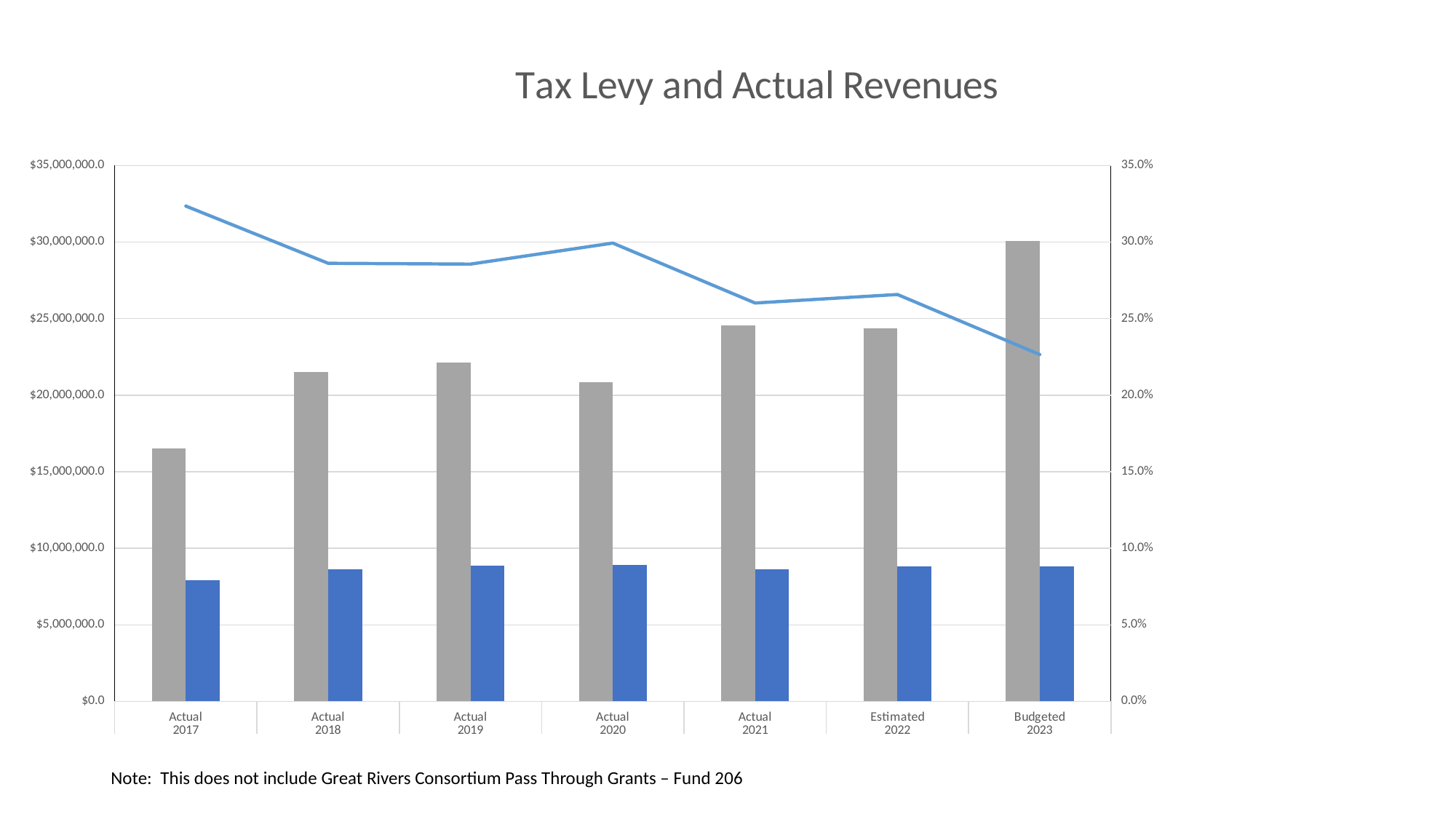
Which category has the lowest point on the blue line? Budgeted 2023 Which is larger, the gray bar for Actual 2021 or the gray bar for Actual 2020? Actual 2021 What kind of chart is shown on the slide? Bar chart with a line Which category has the shortest gray bar? Actual 2017 Which category has the highest point on the blue line? Actual 2017 What is the title of the chart? Tax Levy and Actual Revenues Is the gray bar for Budgeted 2023 greater or less than $25,000,000.0? greater Is the blue line value for Actual 2017 greater or less than 30.0%? greater Which category has the tallest gray bar? Budgeted 2023 How many categories are shown along the x axis? 7 Is the blue bar for Actual 2017 greater or less than $10,000,000.0? less Does the blue line generally rise or fall from Actual 2017 to Budgeted 2023? fall